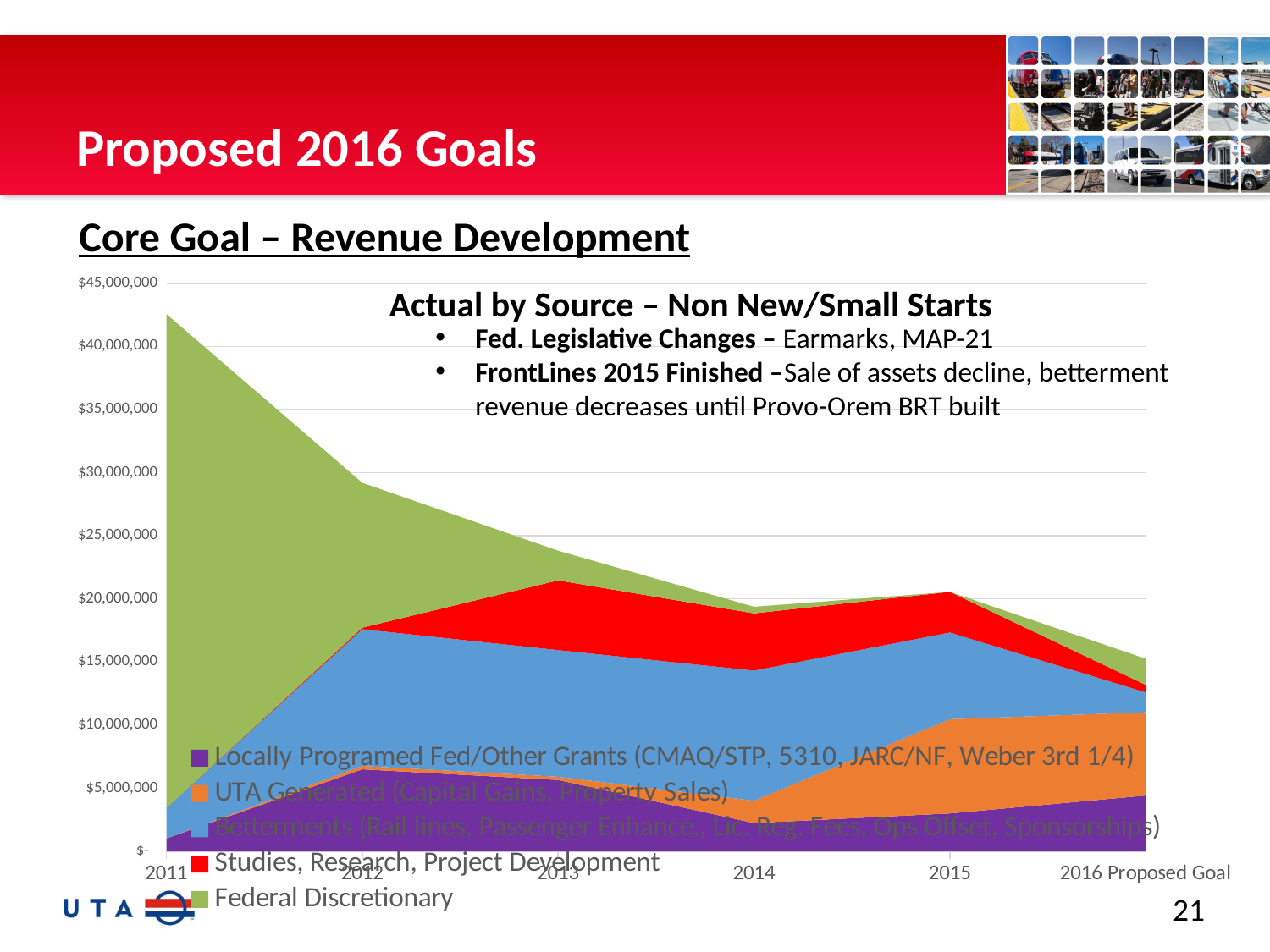
How many points are plotted along the x axis of the chart? 6 Is the total revenue for 2015 greater or less than $25,000,000? less Is the total revenue for 2014 greater or less than $20,000,000? less Is the total revenue for 2012 greater or less than $30,000,000? less Which x-axis category has the lowest total revenue in the chart? 2016 Proposed Goal Does the total revenue rise or fall from 2011 to 2016 Proposed Goal? fall What kind of chart is shown on the slide? Stacked area chart Which is larger, the total revenue in 2011 or in 2012? 2011 What is the title of the chart? Actual by Source – Non New/Small Starts Which year has the highest total revenue in the chart? 2011 How many series does the chart legend list? 5